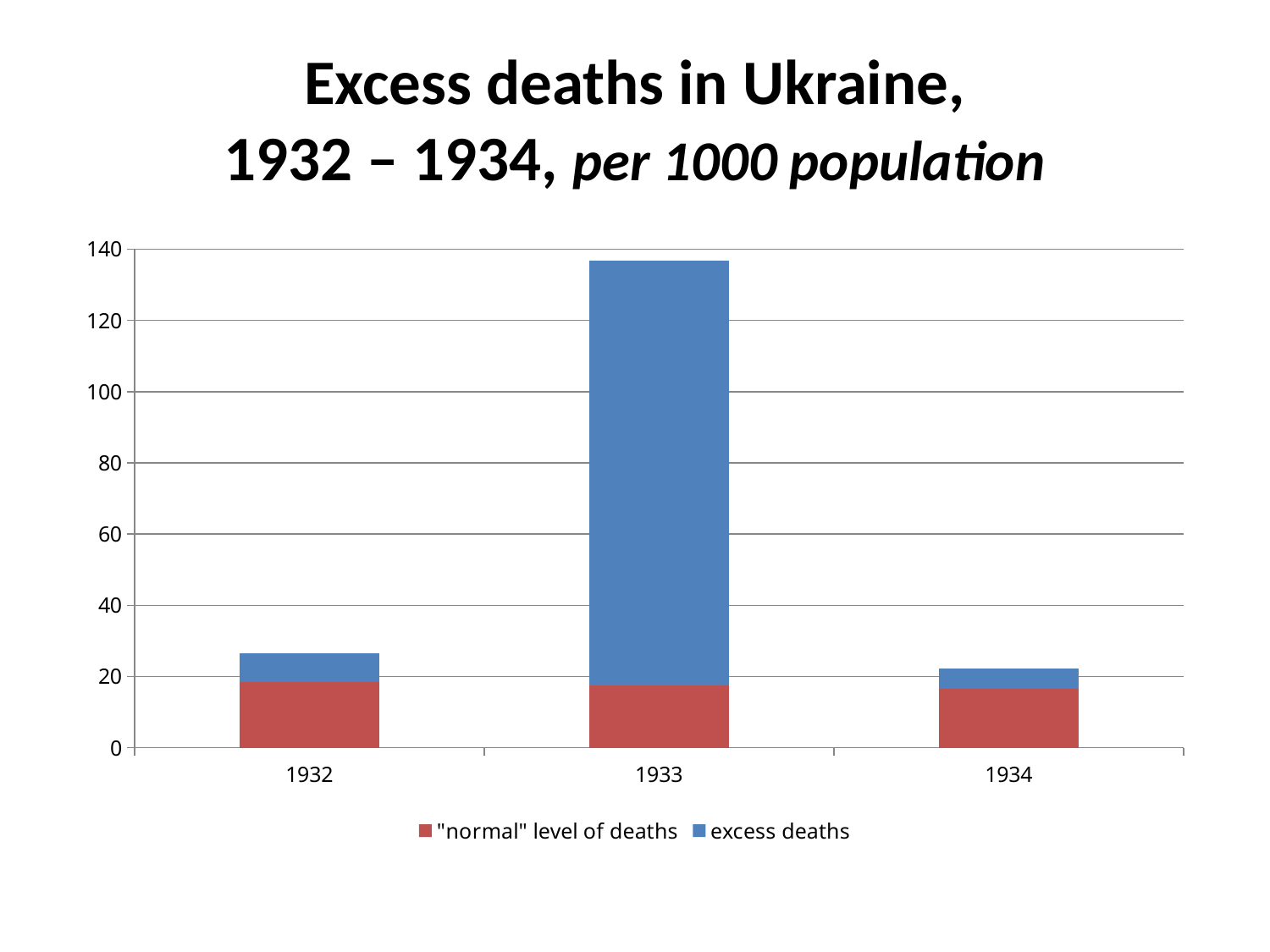
What kind of chart is shown on the slide? stacked bar chart Which year has the larger excess deaths segment, 1932 or 1933? 1933 Is the excess deaths segment for 1933 greater or less than 100? greater Is the total bar for 1932 greater or less than 40? less Which year has the lowest total bar in the chart? 1934 Is the total bar for 1933 greater or less than 120? greater How many years are shown on the x axis of the chart? 3 Which year has the larger total bar, 1932 or 1934? 1932 Which year has the highest total bar in the chart? 1933 How many series does the chart's legend list? 2 Which colour represents excess deaths in the chart? blue